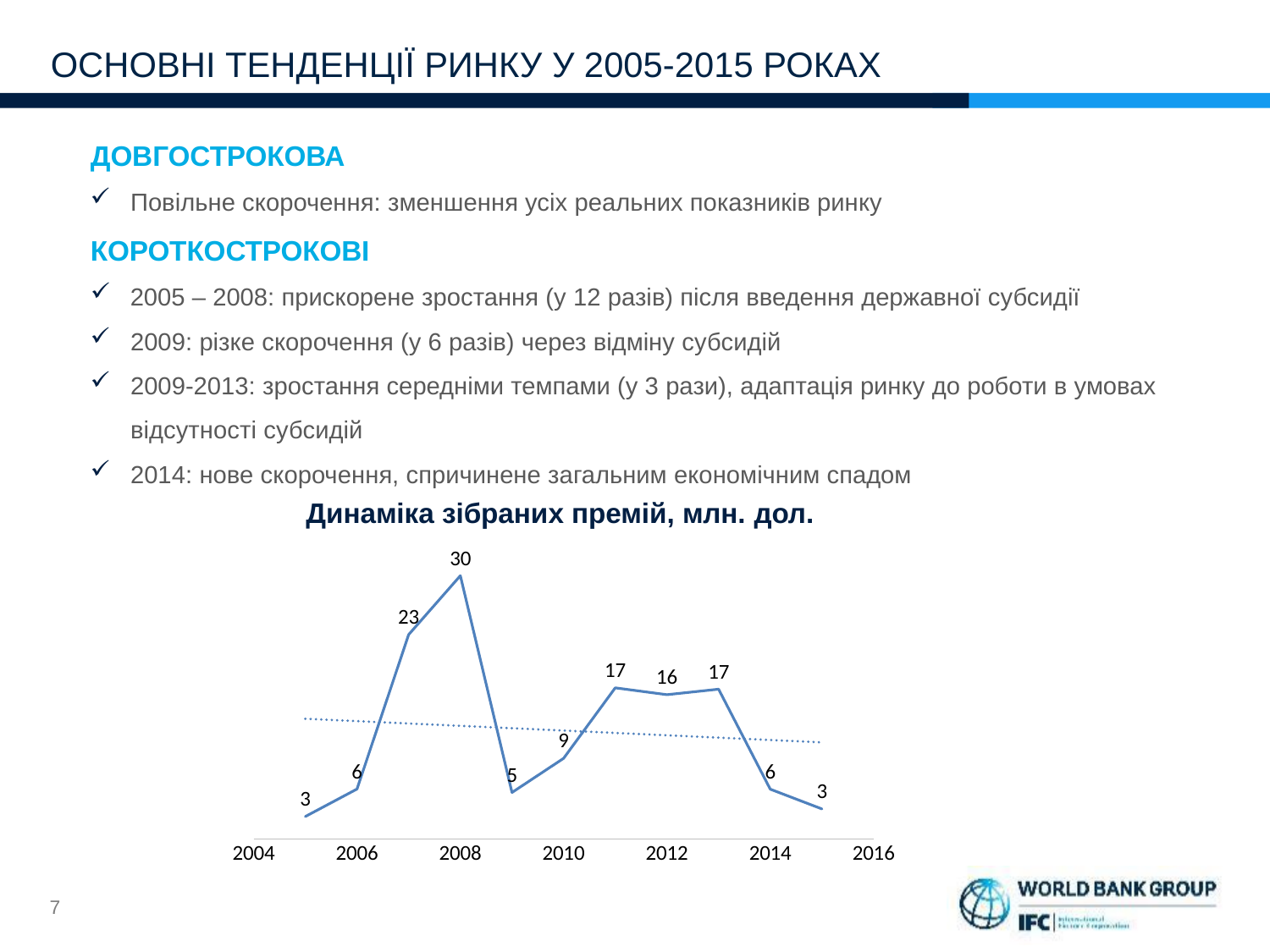
What is the highest value plotted on the chart? 30 In which year does the chart reach its highest value? 2008 What is the value of collected premiums in 2008? 30 What is the value of collected premiums in 2012? 16 What is the value of collected premiums in 2010? 9 What is the value of collected premiums in 2014? 6 What kind of chart is shown on the slide? line chart What is the lowest value plotted on the chart? 3 Which year has the larger value, 2008 or 2012? 2008 What is the difference between the values for 2008 and 2009? 25 How many data points are plotted on the line? 11 What is the title of the chart? Динаміка зібраних премій, млн. дол.